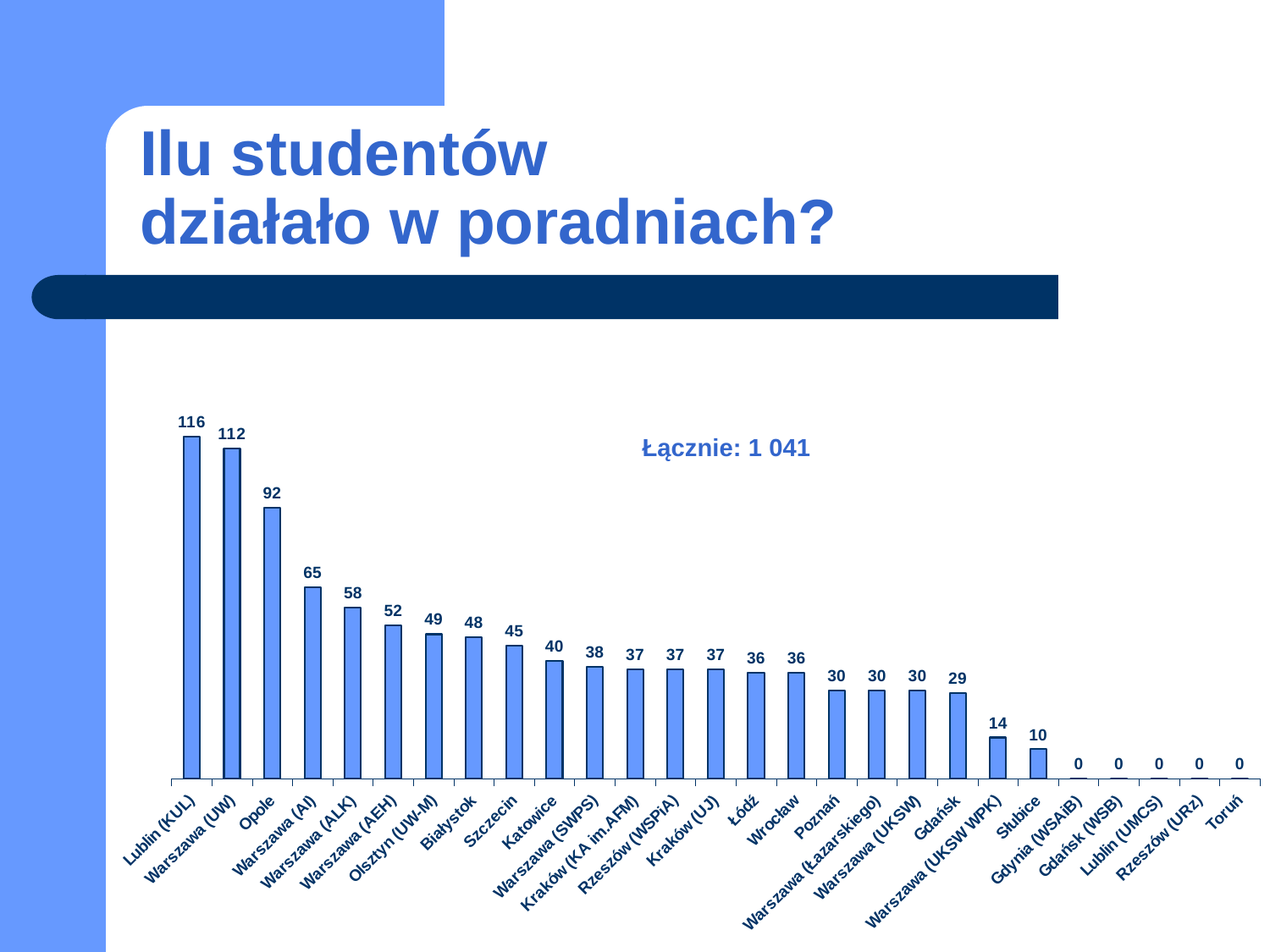
What is the value shown for Opole? 92 Which is larger, the value for Białystok or the value for Szczecin? Białystok What kind of chart is shown on the slide? bar chart Which category has the highest value? Lublin (KUL) How many categories are shown on the x axis? 27 How many students were active at Lublin (KUL)? 116 What is the difference between the values for Opole and Warszawa (AI)? 27 What is the difference between the values for Lublin (KUL) and Warszawa (UW)? 4 What is the value shown for Słubice? 10 What is the value shown for Warszawa (UKSW WPK)? 14 What total is stated in the text label on the chart (Łącznie)? 1 041 How many categories have a value of 0? 5